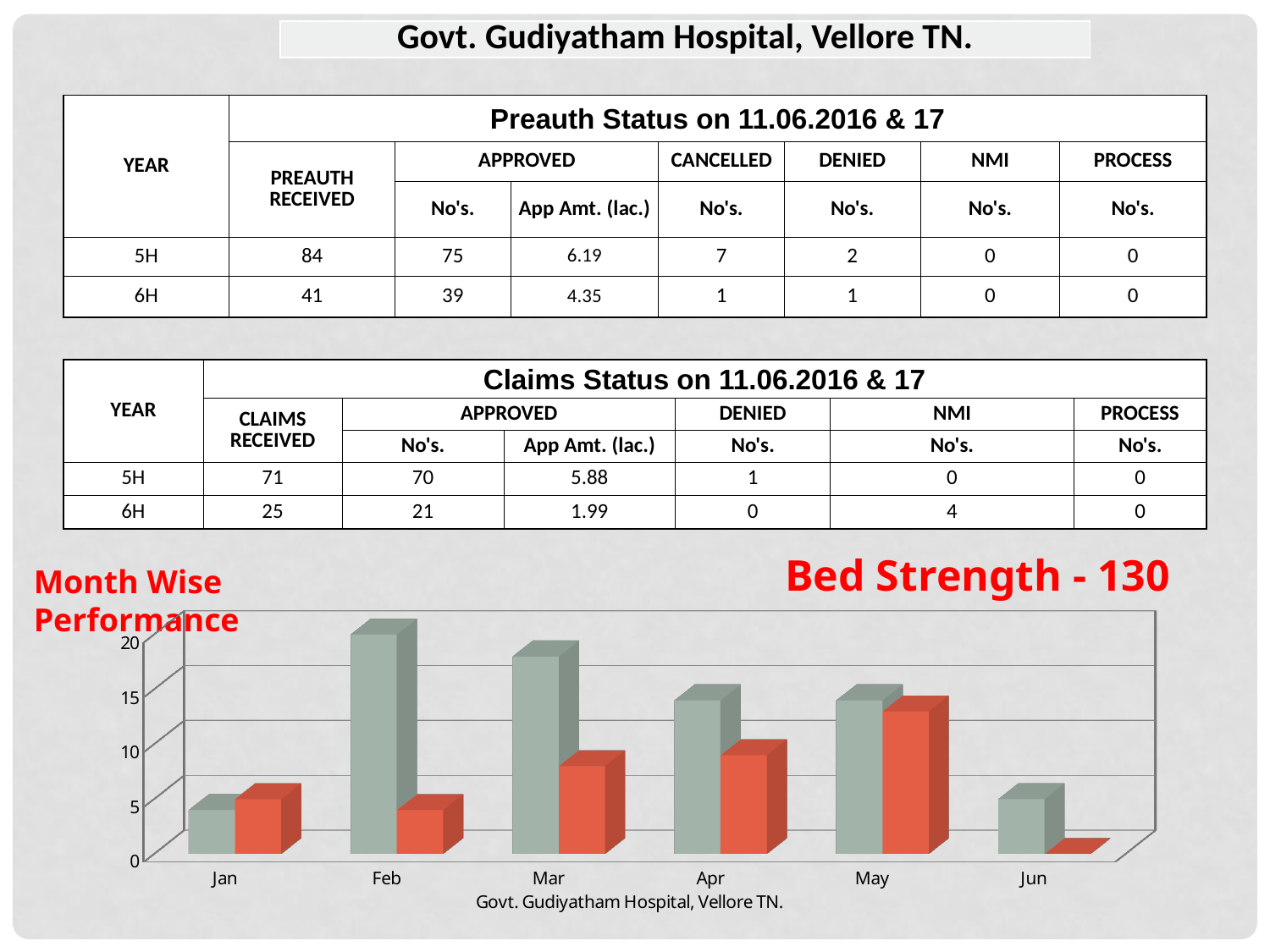
In the Month Wise Performance chart, is the grey bar for Apr greater or less than 10? greater In the Month Wise Performance chart, is the red bar for May greater or less than 10? greater In the Month Wise Performance chart, is the red bar for Jan greater or less than 10? less In the Month Wise Performance chart, which month has the shortest red bar? Jun In the Month Wise Performance chart, which month has the tallest grey bar? Feb In the Month Wise Performance chart, do the grey bars generally rise or fall from Feb to Jun? fall What kind of chart is the Month Wise Performance chart? bar chart How many months are shown on the x axis of the Month Wise Performance chart? 6 What text appears below the x axis of the Month Wise Performance chart? Govt. Gudiyatham Hospital, Vellore TN. In the Month Wise Performance chart, which is larger for Feb, the grey bar or the red bar? the grey bar In the Month Wise Performance chart, which month has the tallest red bar? May